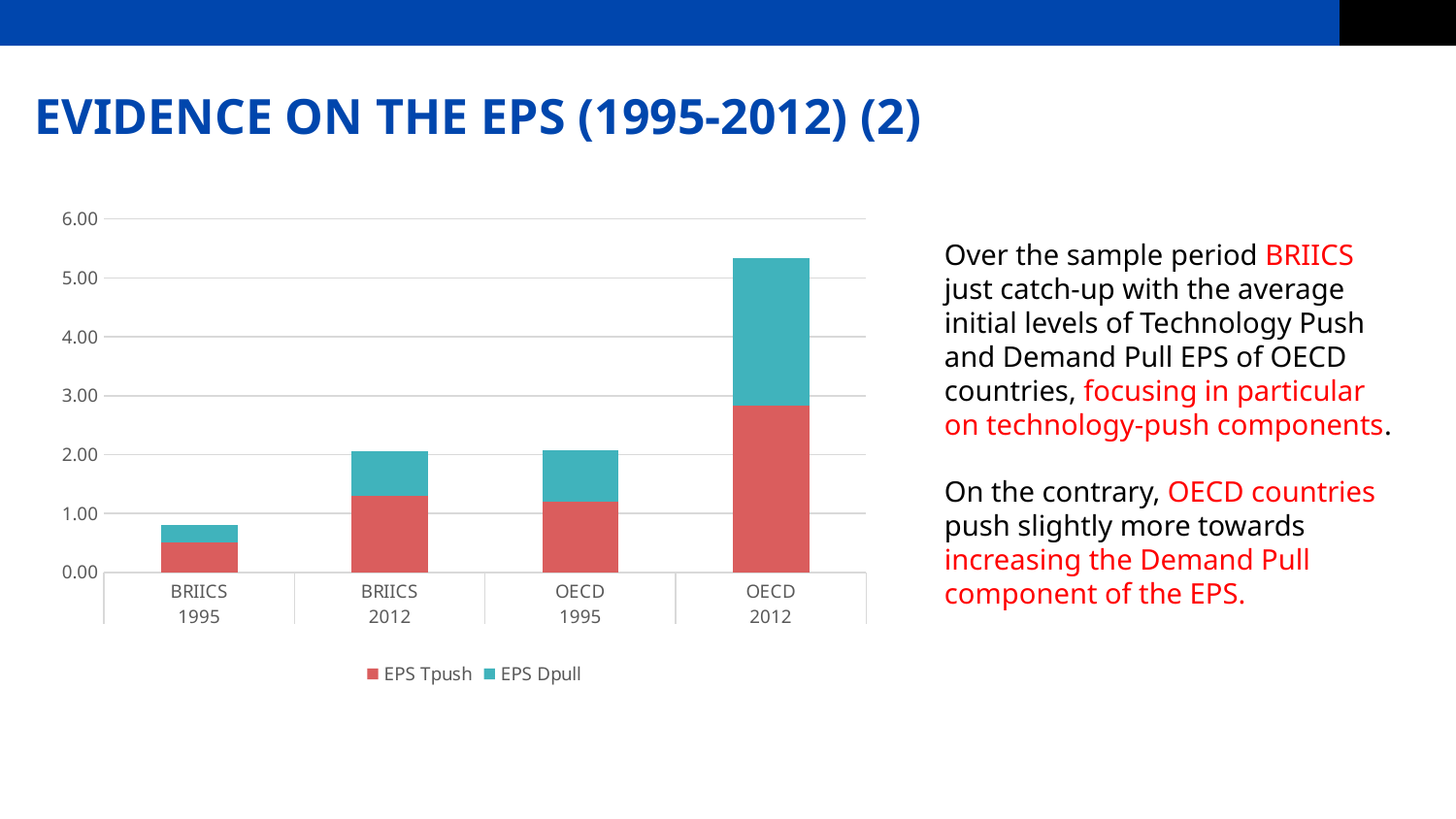
Is the total stacked value for OECD 2012 greater or less than 5.00? greater How many categories are shown on the x axis of the chart? 4 Is the total stacked value for OECD 1995 greater or less than 1.00? greater Is the EPS Tpush value for OECD 2012 greater or less than 2.00? greater Which is larger, the EPS Tpush value for OECD 2012 or the EPS Tpush value for BRIICS 2012? OECD 2012 How many series does the chart legend list? 2 Which category has the shortest stacked bar in the chart? BRIICS 1995 Which category has the tallest stacked bar in the chart? OECD 2012 What kind of chart is shown on the slide? stacked bar chart Which series is shown in red in the chart? EPS Tpush Does the total stacked value for BRIICS rise or fall from 1995 to 2012? rise